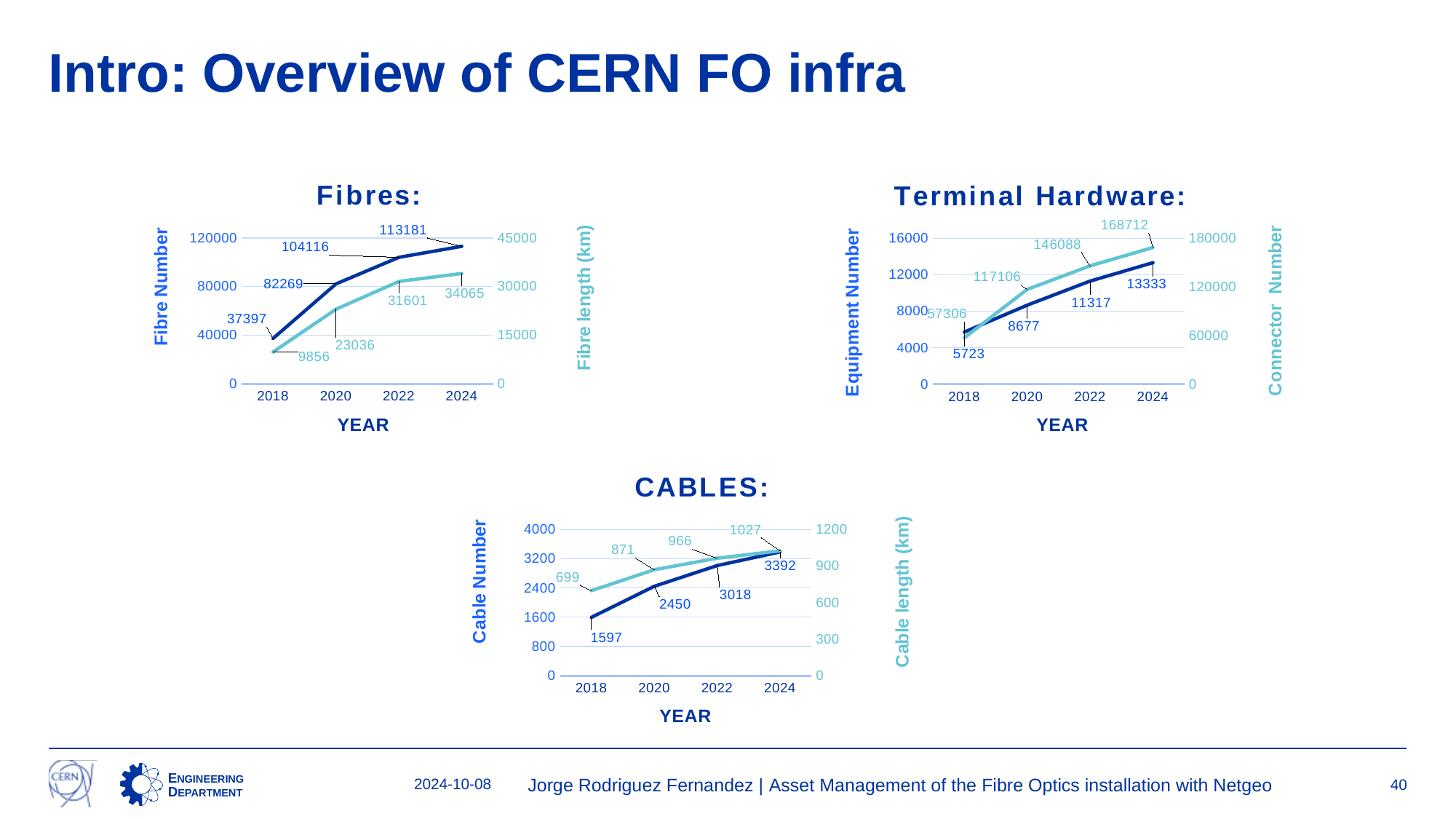
In the Fibres chart, what is the Fibre Number in 2024? 113181 In the CABLES chart, what is the Cable length (km) in 2024? 1027 In the Terminal Hardware chart, what is the Equipment Number in 2020? 8677 In the Terminal Hardware chart, which year has the lowest Equipment Number? 2018 In the Fibres chart, what is the Fibre length (km) in 2018? 9856 How many years are plotted on the x axis of the Fibres chart? 4 In the CABLES chart, what is the difference in Cable Number between 2022 and 2020? 568 In the Fibres chart, which is larger: the Fibre length (km) in 2022 or in 2020? 2022 In the Fibres chart, by how much did the Fibre Number increase from 2018 to 2024? 75784 What type of chart is the CABLES chart? line chart In the CABLES chart, does the Cable Number rise or fall from 2018 to 2024? rise In the Terminal Hardware chart, what is the Connector Number in 2022? 146088